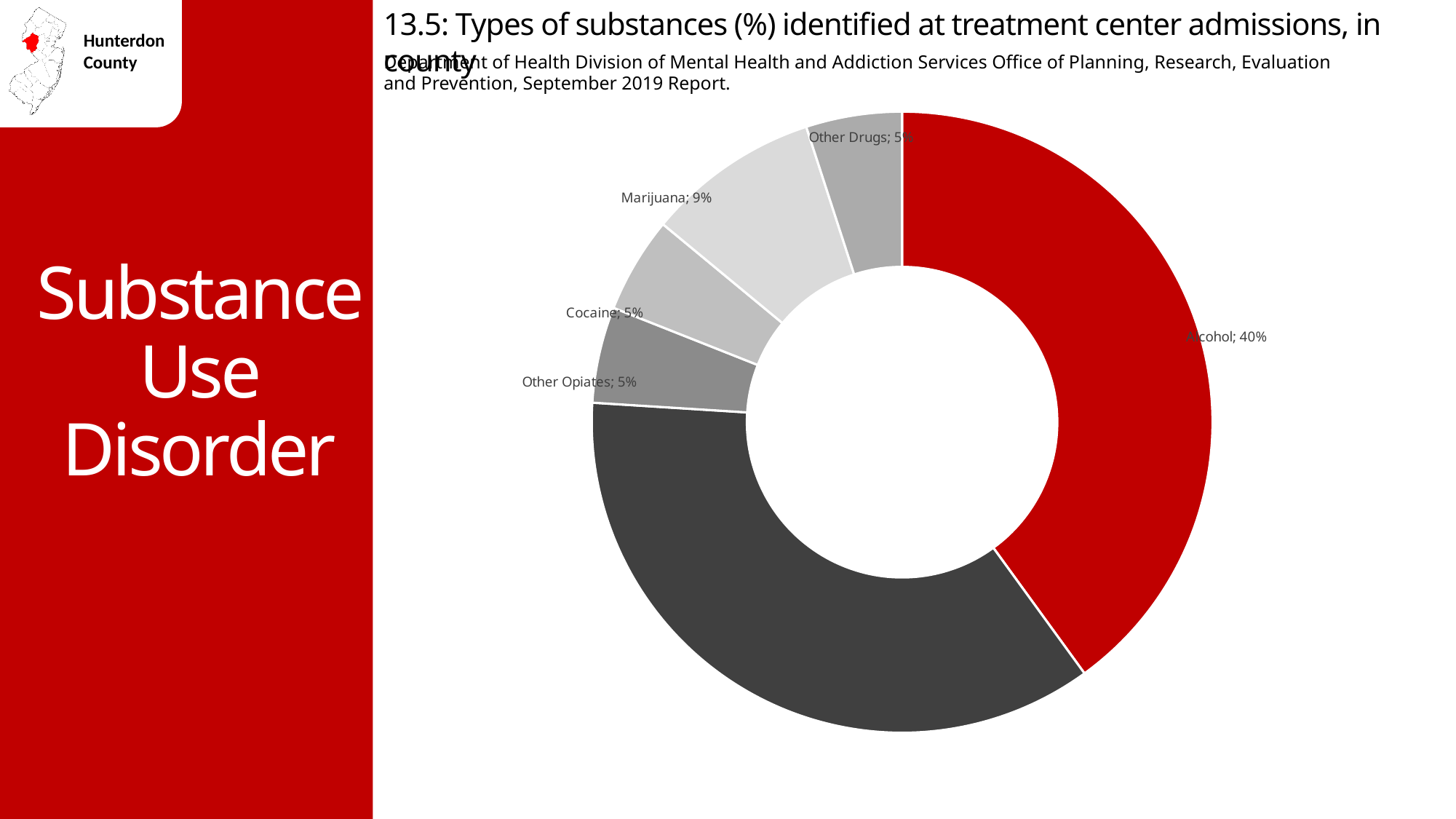
What is the figure number and title of the chart? 13.5: Types of substances (%) identified at treatment center admissions, in county What kind of chart is shown on the slide? Doughnut (pie) chart What percentage is shown for Other Drugs? 5% How many slices does the chart contain? 6 What percentage is shown for Cocaine? 5% What colour is the Alcohol slice? Red Which has a larger share, Alcohol or Other Opiates? Alcohol What percentage is shown for Marijuana? 9% How many percentage points higher is Alcohol than Marijuana? 31 percentage points What percentage is shown for Other Opiates? 5% Which has a larger share, Marijuana or Cocaine? Marijuana What percentage of treatment center admissions is attributed to Alcohol? 40%